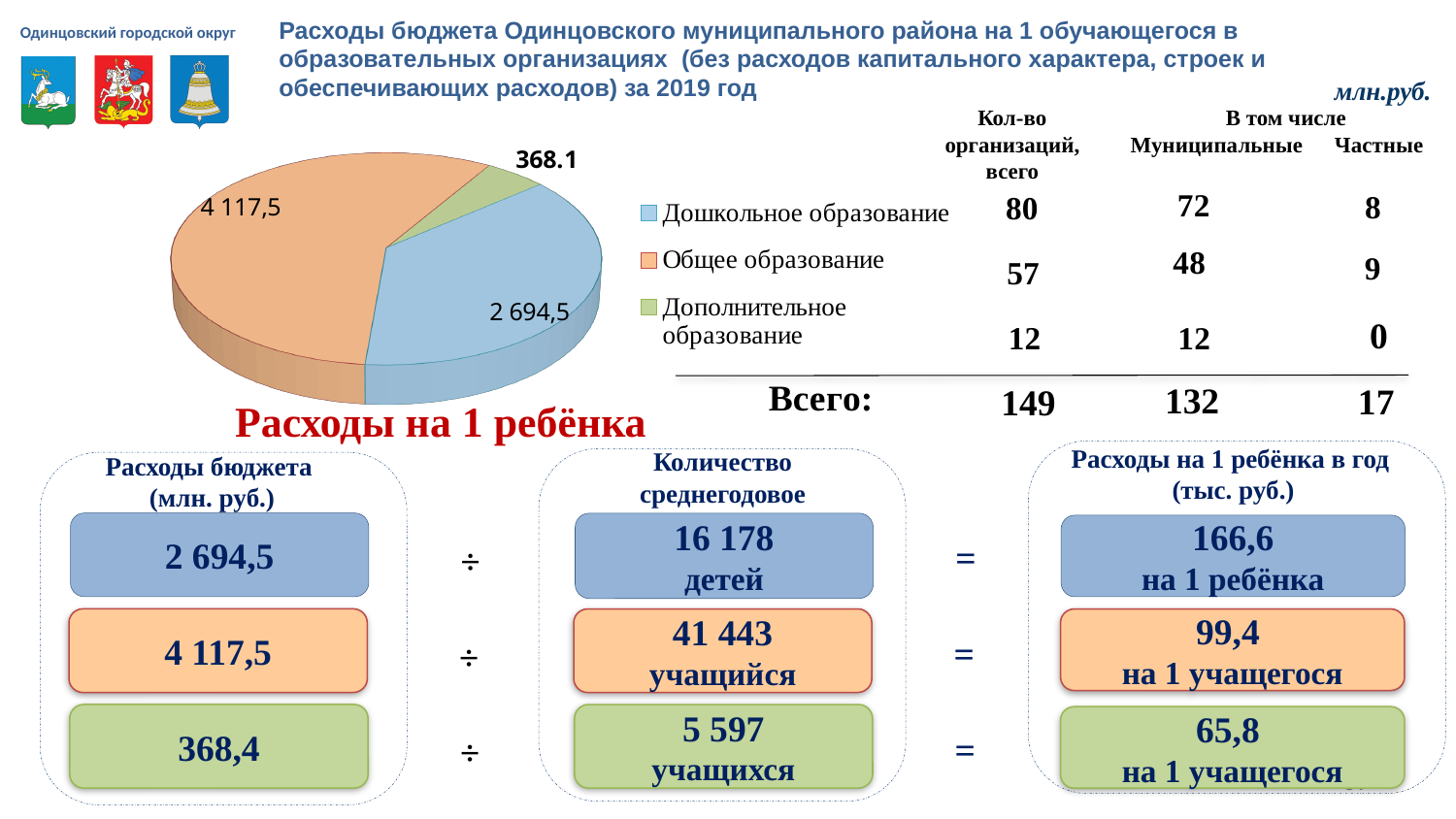
Which is larger in the pie chart: Дошкольное образование or Общее образование? Общее образование Which colour represents Дополнительное образование in the pie chart? green What value does the pie chart show for Общее образование? 4 117,5 What is the difference between the values for Общее образование and Дошкольное образование in the pie chart? 1 423,0 What value does the pie chart show for Дополнительное образование? 368.1 What kind of chart is shown on the slide? pie chart Which category has the smallest slice in the pie chart? Дополнительное образование Which category has the largest slice in the pie chart? Общее образование What is the total of all three values shown in the pie chart? 7 180,1 What value does the pie chart show for Дошкольное образование? 2 694,5 How many entries does the pie chart's legend list? 3 How many slices does the pie chart have? 3